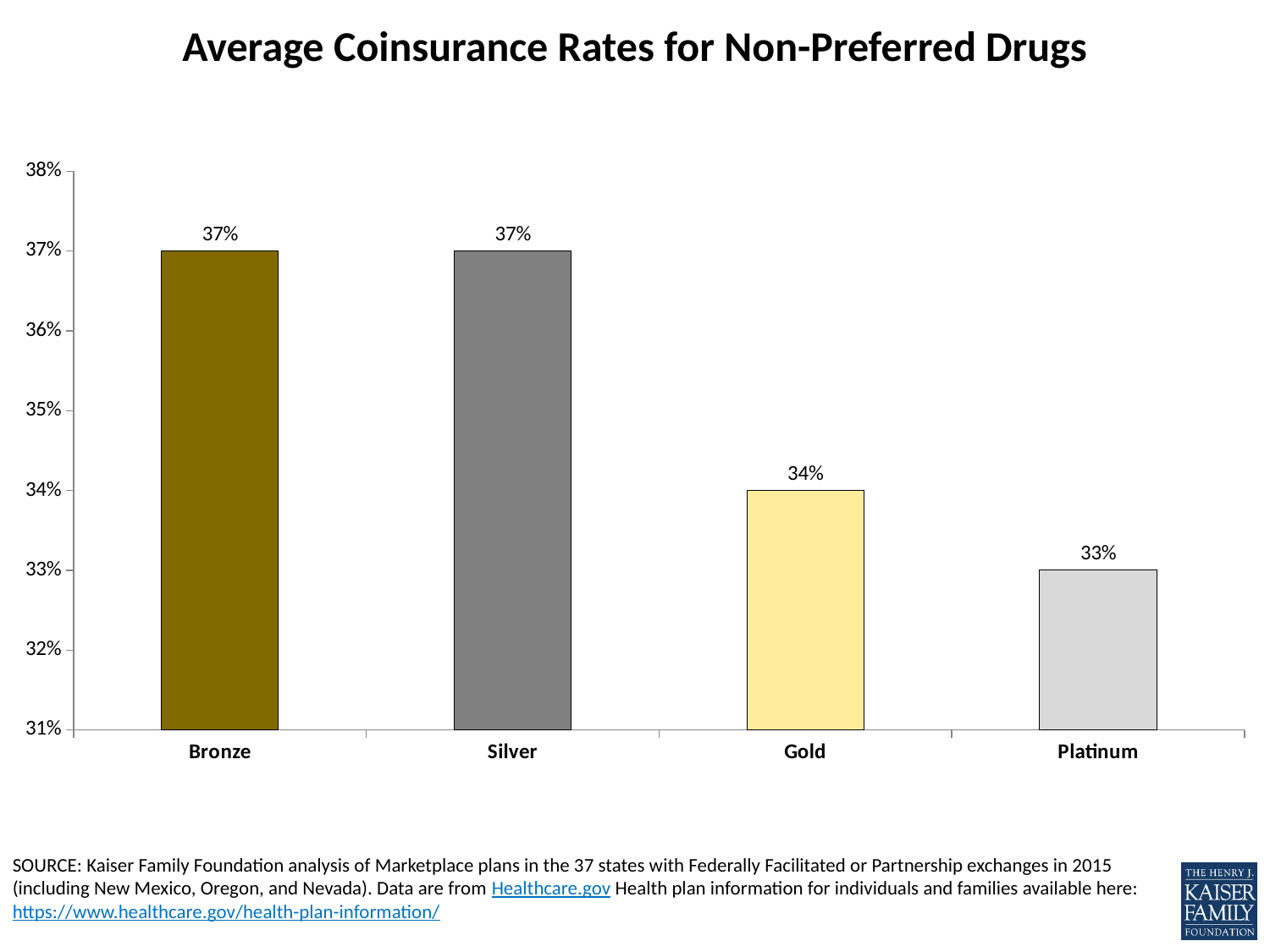
What is the average coinsurance rate for non-preferred drugs for Platinum plans? 33% What is the title of the chart? Average Coinsurance Rates for Non-Preferred Drugs Which has a higher average coinsurance rate, Silver or Gold? Silver Which plan type has the lowest average coinsurance rate for non-preferred drugs? Platinum What kind of chart is shown on the slide? Bar chart What is the average coinsurance rate for non-preferred drugs for Bronze plans? 37% What is the difference between the average coinsurance rates for Gold and Platinum plans? 1 percentage point What is the average coinsurance rate for non-preferred drugs for Silver plans? 37% Is the average coinsurance rate for Gold plans greater or less than 35%? less What is the average coinsurance rate for non-preferred drugs for Gold plans? 34% What is the difference between the average coinsurance rates for Bronze and Platinum plans? 4 percentage points How many plan types are shown in the chart? 4